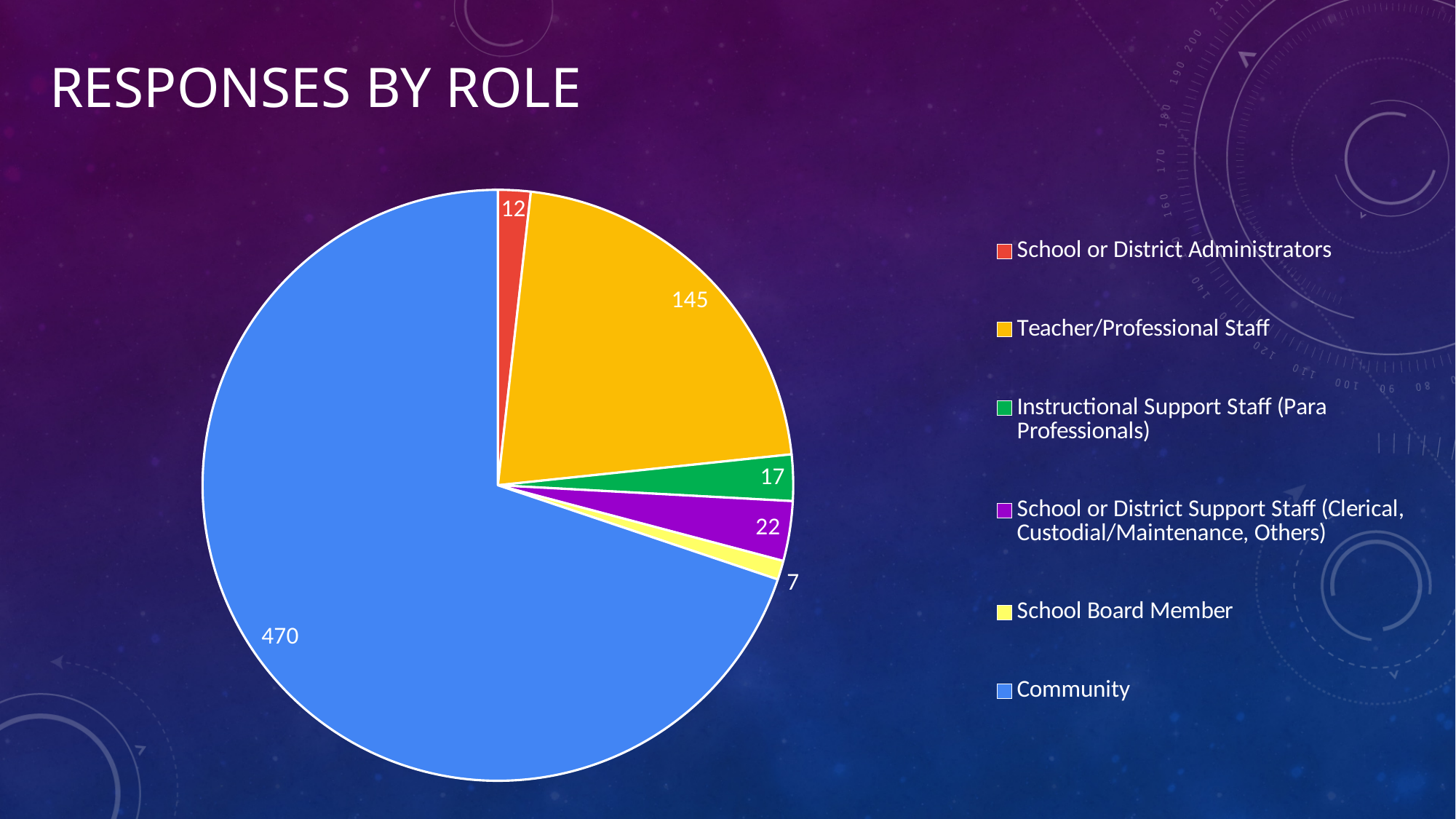
What kind of chart is shown on the slide? Pie chart How many responses came from Community? 470 Which has more responses: Instructional Support Staff (Para Professionals) or School or District Support Staff (Clerical, Custodial/Maintenance, Others)? School or District Support Staff (Clerical, Custodial/Maintenance, Others) What is the total number of responses across all roles? 673 Which role has the largest number of responses? Community Which role has the smallest number of responses? School Board Member What is the title of the chart? Responses by Role How many responses came from School Board Members? 7 How many responses came from School or District Administrators? 12 How many roles (slices) are shown in the pie chart? 6 How many responses came from Teacher/Professional Staff? 145 What is the difference between the Community responses and the Teacher/Professional Staff responses? 325